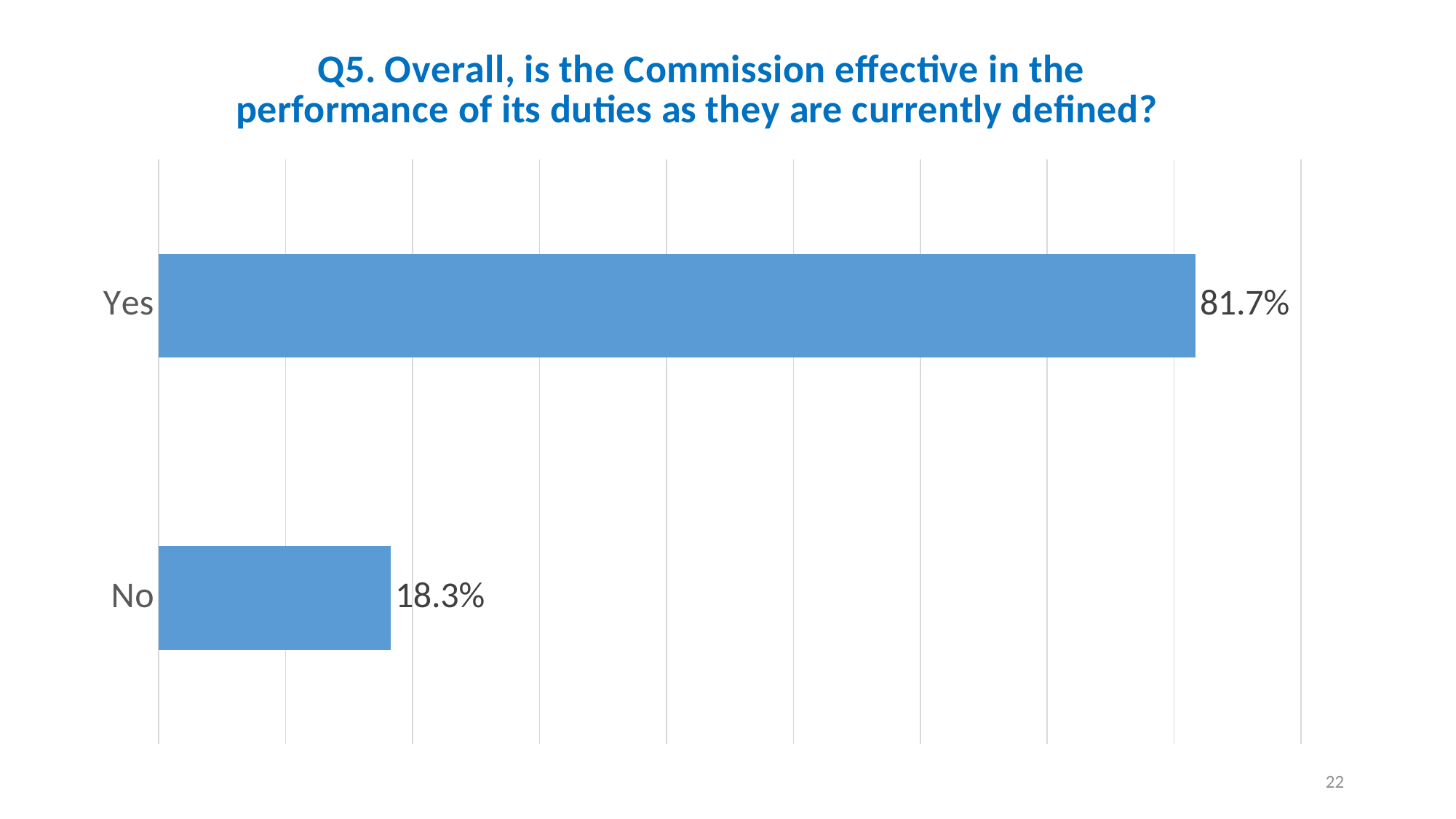
What percentage of respondents answered Yes? 81.7% Which response has the lowest value? No What is the total of the Yes and No percentages? 100% How many response categories are shown in the chart? 2 Which is larger, the value for Yes or the value for No? Yes What is the title of the chart? Q5. Overall, is the Commission effective in the performance of its duties as they are currently defined? What is the difference between the Yes and No percentages? 63.4% What colour are the bars in the chart? Blue What kind of chart is shown on the slide? Bar chart What percentage of respondents answered No? 18.3% Which response has the highest value? Yes